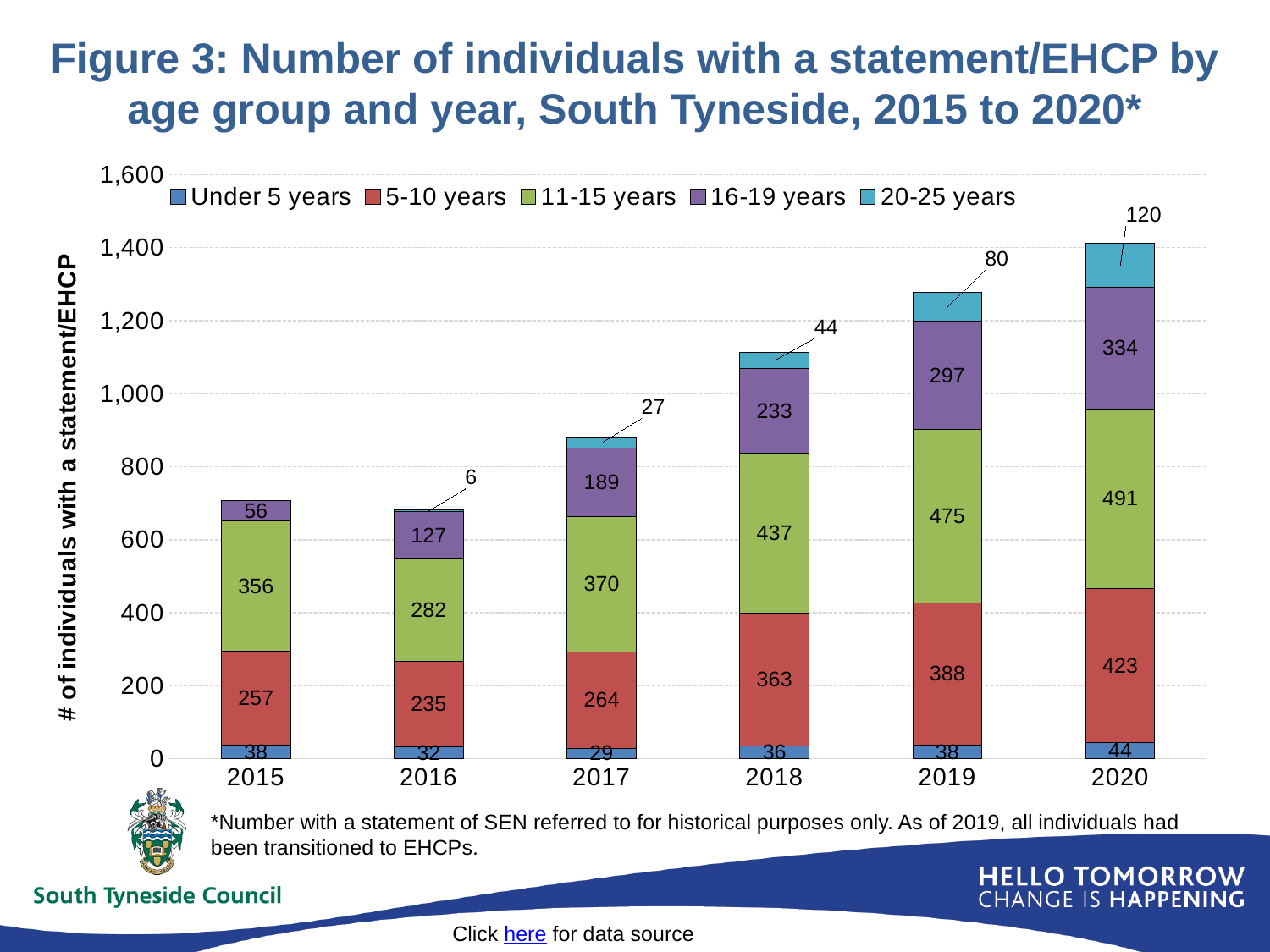
In 2019, which is larger: the 5-10 years value or the 16-19 years value? 5-10 years Is the total height of the 2016 bar greater or less than 800? less How many series does the legend list? 5 What is the value for the 16-19 years group in 2020? 334 Which year has the lowest value for the Under 5 years group? 2017 How many years are shown on the x axis? 6 What is the total of the stacked bar for 2020? 1,412 What is the difference between the 11-15 years value in 2020 and in 2015? 135 Which year has the highest value for the 5-10 years group? 2020 What is the value for the 20-25 years group in 2017? 27 What kind of chart is shown on the slide? Stacked bar chart What is the value for the 11-15 years group in 2018? 437